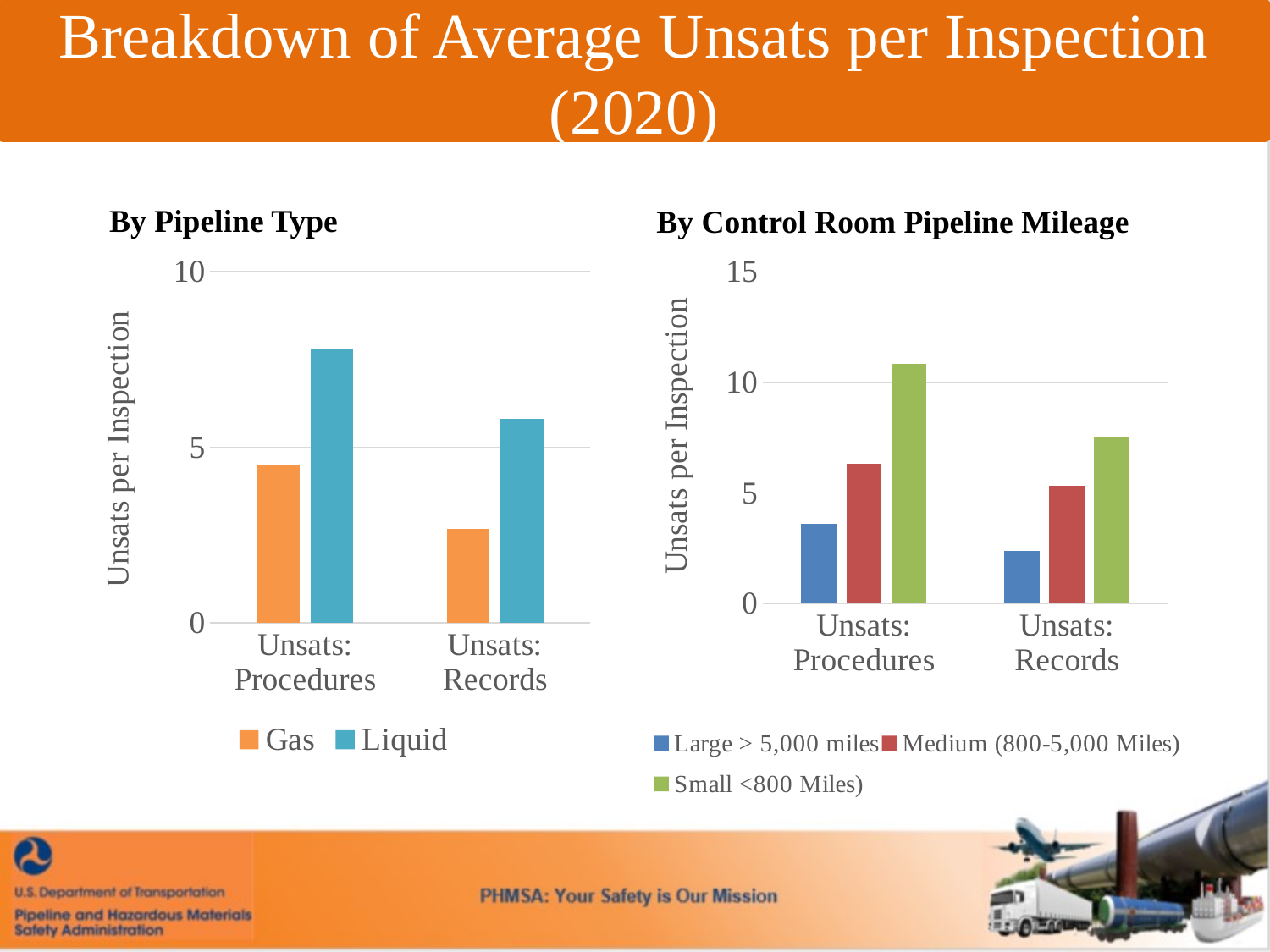
In the 'By Control Room Pipeline Mileage' chart, is the Small <800 Miles) value for Unsats: Procedures greater or less than 10? greater In the 'By Control Room Pipeline Mileage' chart, which series has the highest value for Unsats: Procedures? Small <800 Miles) In the 'By Control Room Pipeline Mileage' chart, is the Large > 5,000 miles value for Unsats: Procedures greater or less than 5? less In the 'By Pipeline Type' chart, is the Liquid value for Unsats: Procedures greater or less than 5? greater What is the y-axis label of the 'By Pipeline Type' chart? Unsats per Inspection What kind of chart is the 'By Pipeline Type' chart? bar chart In the 'By Control Room Pipeline Mileage' chart, do the Medium (800-5,000 Miles) values rise or fall from Unsats: Procedures to Unsats: Records? fall How many series does the legend of the 'By Control Room Pipeline Mileage' chart list? 3 How many categories are shown on the x axis of the 'By Pipeline Type' chart? 2 In the 'By Control Room Pipeline Mileage' chart, which series has the lowest value for Unsats: Records? Large > 5,000 miles In the 'By Pipeline Type' chart, which series has the larger value for Unsats: Records, Gas or Liquid? Liquid